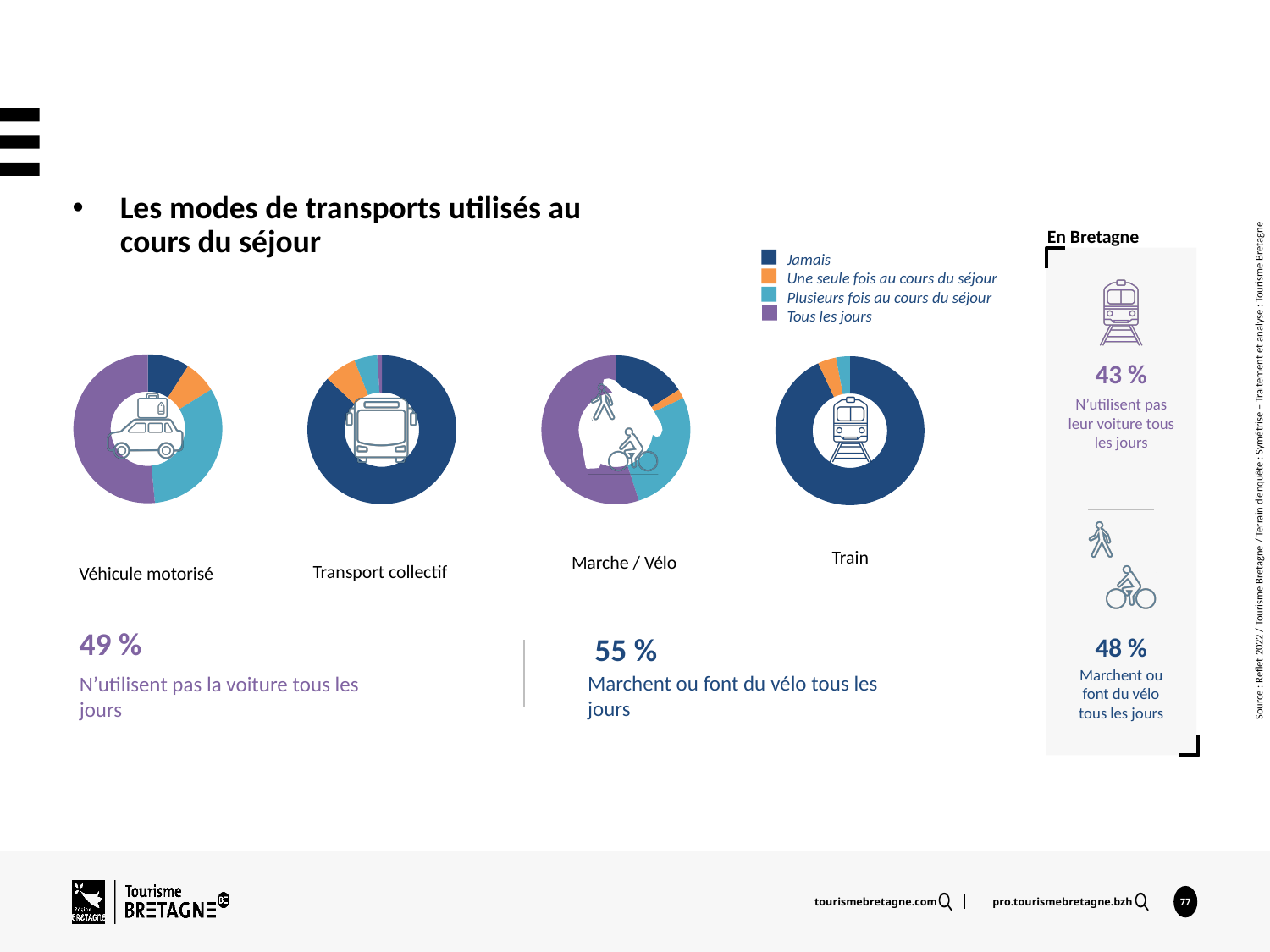
What kind of chart is used to show the modes of transport used during the stay? Pie (donut) chart In the Train donut chart, which category has the largest slice? Jamais In the Transport collectif donut chart, which category has the largest slice? Jamais Which legend entry is shown in orange? Une seule fois au cours du séjour How many categories does the legend list for the donut charts? 4 According to the slide, what percentage of visitors walk or cycle every day (Marchent ou font du vélo tous les jours)? 55 % In the Véhicule motorisé donut chart, which category has the largest slice? Tous les jours According to the slide, what percentage of visitors do not use their car every day (N'utilisent pas la voiture tous les jours)? 49 % How many donut charts are shown on the slide? 4 In the Véhicule motorisé donut chart, which category has the smallest slice? Une seule fois au cours du séjour In the Véhicule motorisé donut chart, which slice is larger: Jamais or Tous les jours? Tous les jours